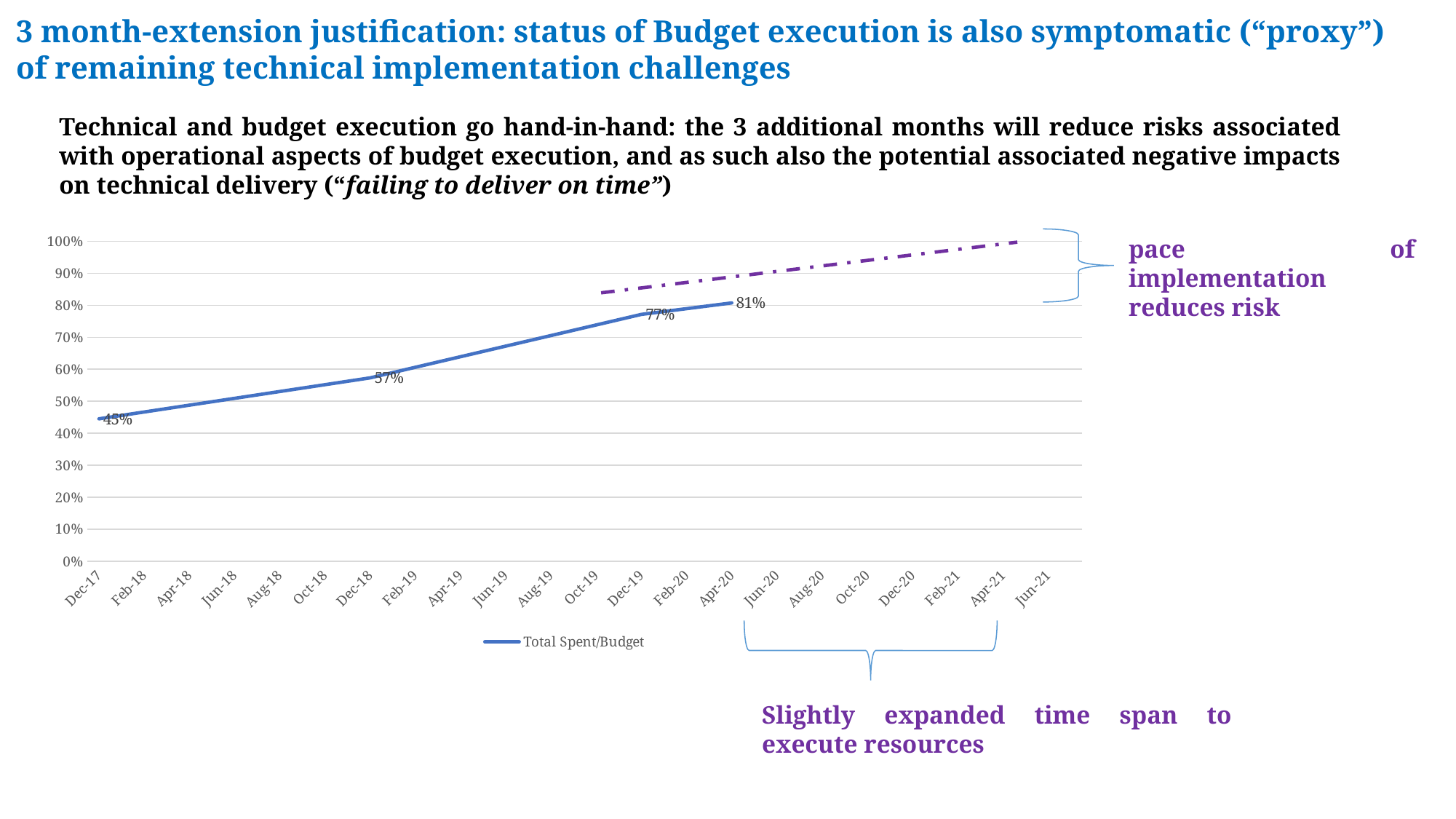
What is the difference between the Total Spent/Budget values at Dec-19 and Dec-18? 20% What is the value of Total Spent/Budget at Dec-19? 77% Which labelled point has the lowest Total Spent/Budget value? Dec-17 How many series does the chart legend list? 1 What is the difference between the Total Spent/Budget values at Apr-20 and Dec-17? 36% Which labelled point has the highest Total Spent/Budget value? Apr-20 What is the value of Total Spent/Budget at Dec-18? 57% Which is larger, the Total Spent/Budget value at Dec-18 or at Dec-19? Dec-19 What kind of chart is shown on the slide? line chart What is the value of Total Spent/Budget at Apr-20? 81% Does the Total Spent/Budget line rise or fall from Dec-17 to Apr-20? rise What is the value of Total Spent/Budget at Dec-17? 45%